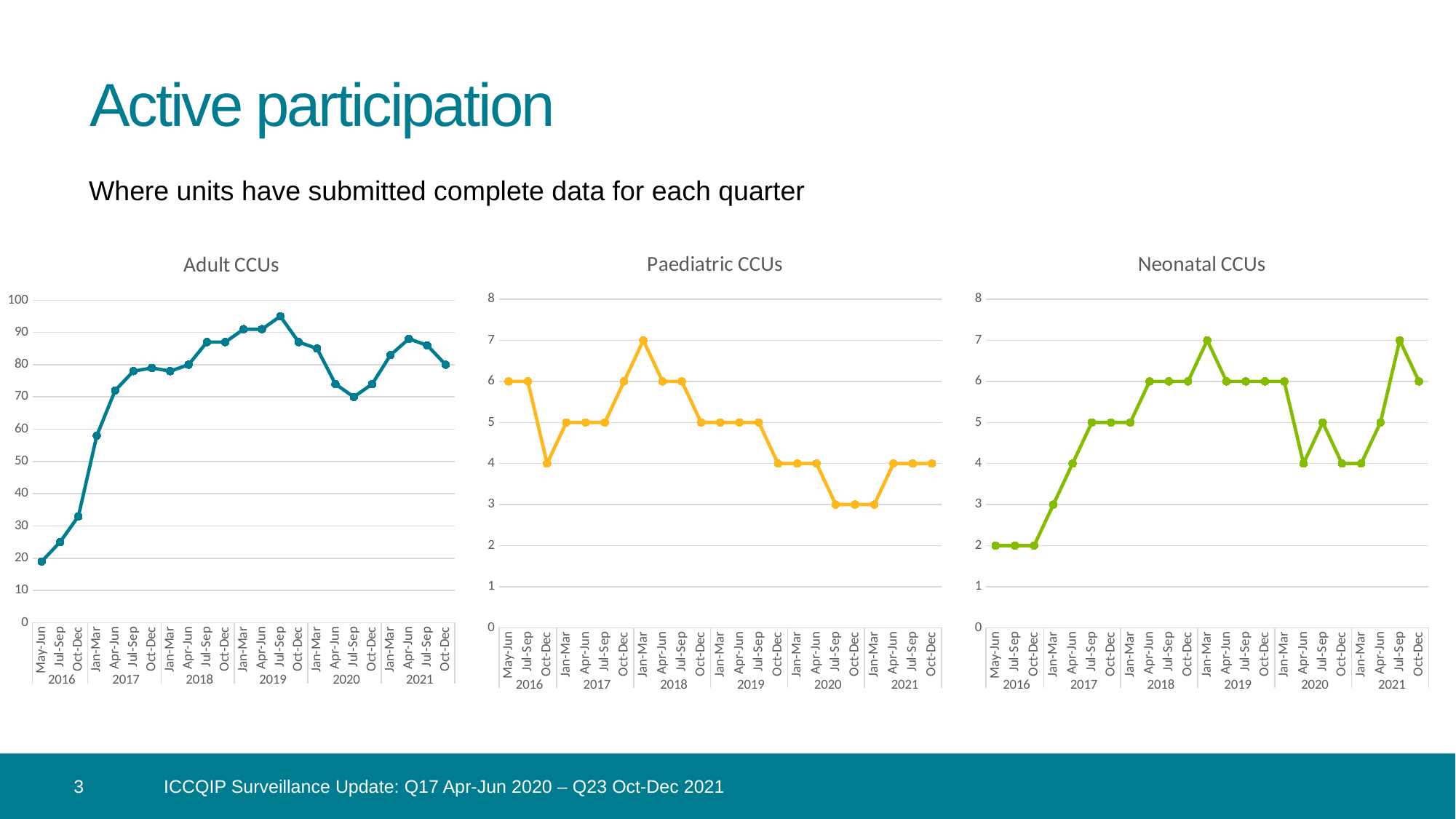
In the Neonatal CCUs chart, what is the difference between the value for Jan-Mar 2019 and the value for Apr-Jun 2020? 3 In the Neonatal CCUs chart, is the value for Oct-Dec 2021 larger than the value for Oct-Dec 2020? Yes In the Neonatal CCUs chart, what is the value for May-Jun 2016? 2 In the Adult CCUs chart, is the value for May-Jun 2016 greater or less than 30? less In the Neonatal CCUs chart, what is the value for Jul-Sep 2021? 7 What kind of chart is the Adult CCUs chart? line chart In the Adult CCUs chart, is the value for Jul-Sep 2019 greater or less than 90? greater In the Paediatric CCUs chart, which quarter has the highest value? Jan-Mar 2018 How many quarters are plotted in the Paediatric CCUs chart? 23 In the Paediatric CCUs chart, what is the value for Oct-Dec 2021? 4 In the Paediatric CCUs chart, what is the value for Jan-Mar 2018? 7 In the Paediatric CCUs chart, what is the difference between the value for Jul-Sep 2016 and the value for Oct-Dec 2016? 2